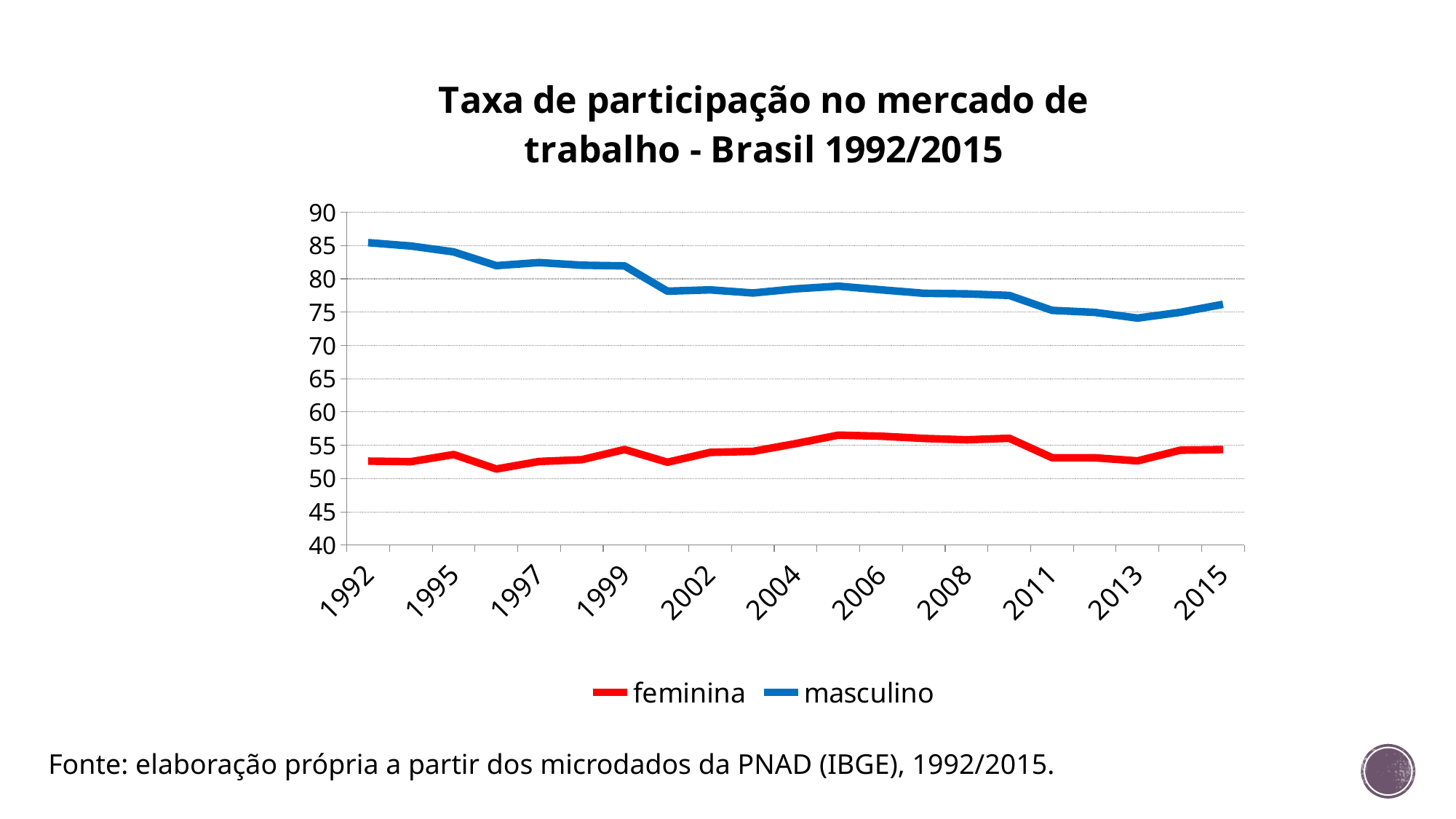
How many series does the legend list? 2 Which series has the higher value in 2015, feminina or masculino? masculino Is the value for feminina in 1992 greater or less than 60? less What is the title of the chart? Taxa de participação no mercado de trabalho - Brasil 1992/2015 Does the masculino series rise or fall overall from 1992 to 2015? fall Is the masculino value larger in 1992 or in 2015? 1992 Is the value for masculino in 1992 greater or less than 80? greater Is the value for masculino in 2013 greater or less than 70? greater What kind of chart is shown on the slide? line chart Which series is drawn in red? feminina